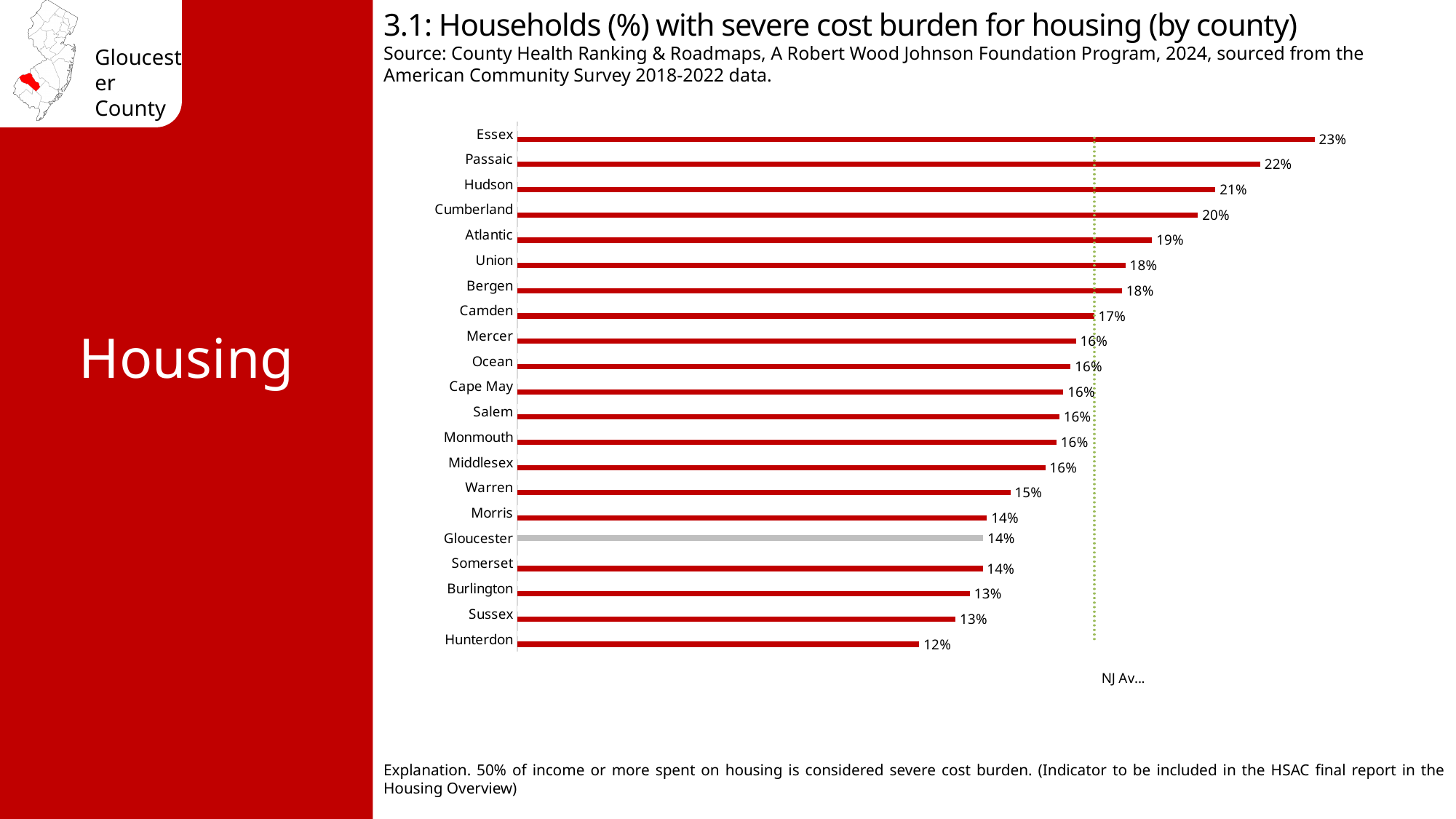
Which county has the highest percentage of households with severe cost burden for housing? Essex What kind of chart is shown on the slide? Bar chart What is the difference between the values for Passaic and Gloucester? 8% What is the value for Hunterdon? 12% What is the difference between the values for Essex and Hunterdon? 11% Which county's bar is shown in gray rather than red? Gloucester How many counties are shown in the chart? 21 Which county has the lowest percentage of households with severe cost burden for housing? Hunterdon What is the value for Gloucester? 14% Which has a larger value, Cumberland or Atlantic? Cumberland What is the value for Camden? 17% What is the value for Essex? 23%